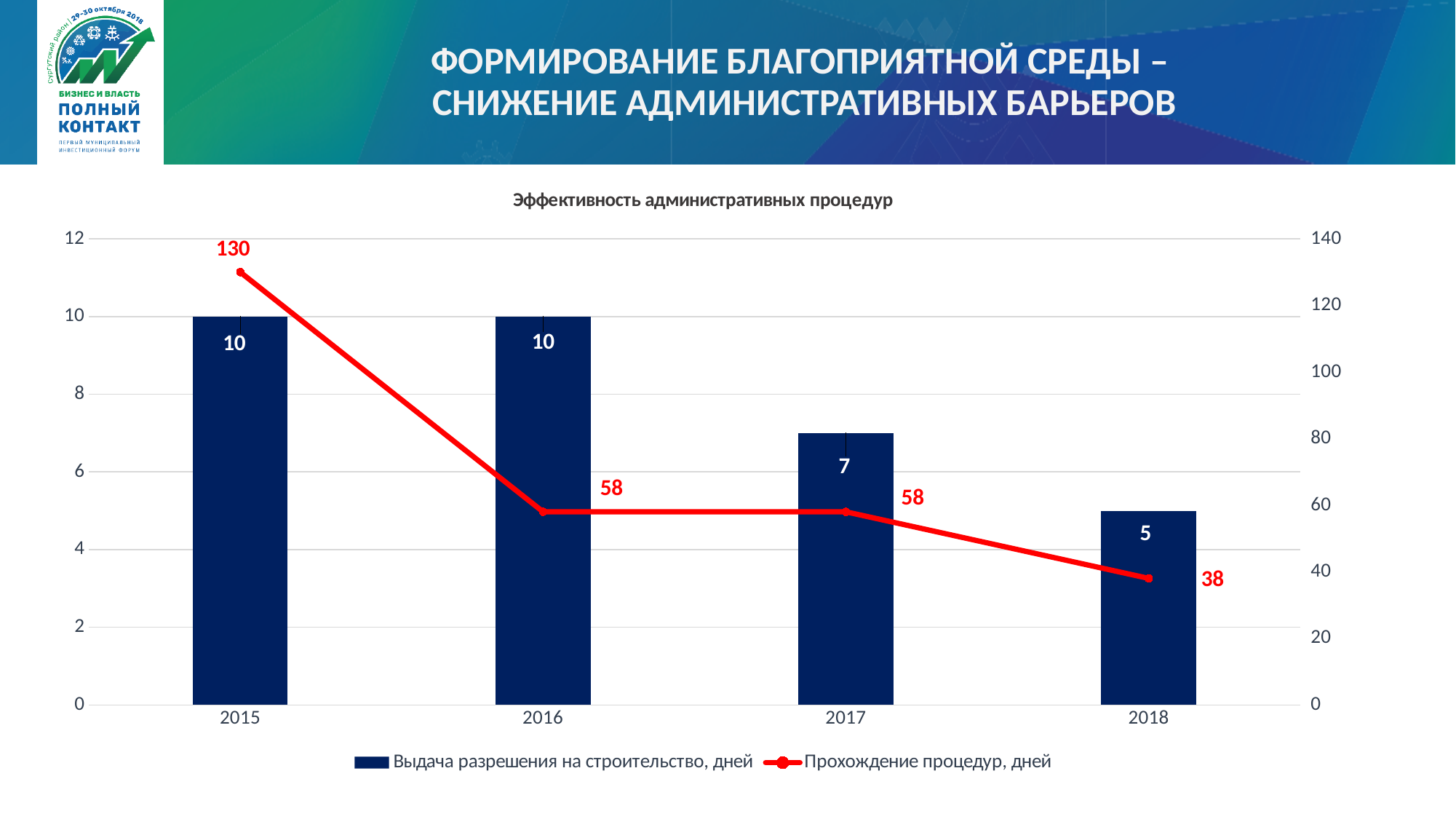
Is the 'Прохождение процедур, дней' value for 2017 larger or smaller than the value for 2018? larger What is the difference between the 'Выдача разрешения на строительство, дней' values for 2016 and 2018? 5 What is the value of 'Прохождение процедур, дней' for 2018? 38 Which year has the lowest value for 'Выдача разрешения на строительство, дней'? 2018 What is the value of 'Выдача разрешения на строительство, дней' for 2017? 7 What is the value of 'Прохождение процедур, дней' for 2015? 130 What is the overall trend of 'Прохождение процедур, дней' from 2015 to 2018? falling How many series does the legend list? 2 Which year has the highest value for 'Прохождение процедур, дней'? 2015 What is the title of the chart? Эффективность административных процедур What is the difference between the 'Прохождение процедур, дней' values for 2015 and 2016? 72 How many years are shown on the x axis? 4